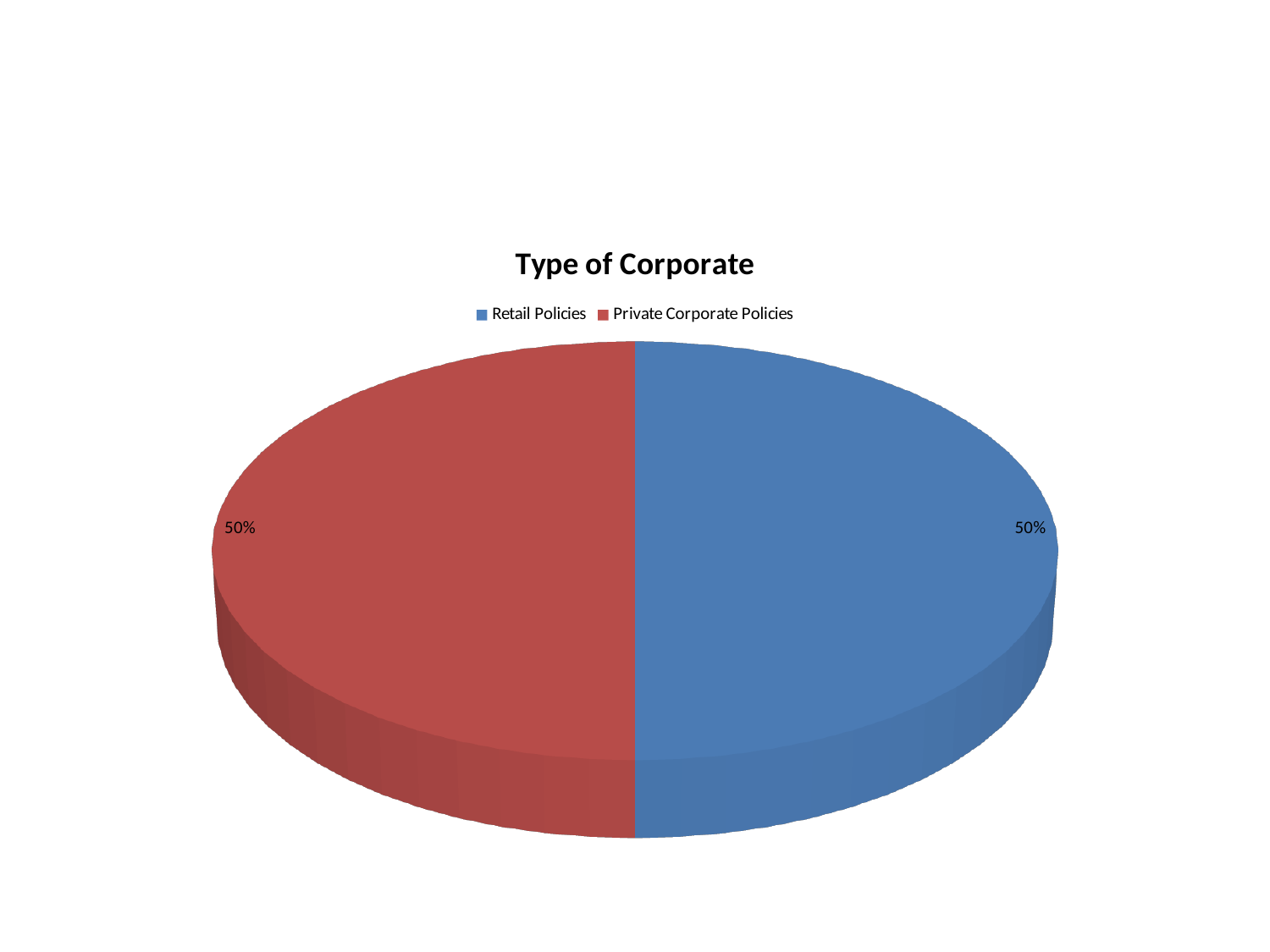
What kind of chart is shown on the slide? pie chart What share of the pie does Private Corporate Policies have? 50% How many slices does the pie chart have? 2 What is the difference between the shares of Retail Policies and Private Corporate Policies? 0% What is the title of the chart? Type of Corporate How many entries does the legend list? 2 Is the share for Private Corporate Policies greater or less than 75%? less Which colour represents Retail Policies in the chart? blue Is the share for Retail Policies greater or less than 25%? greater What share of the pie does Retail Policies have? 50%